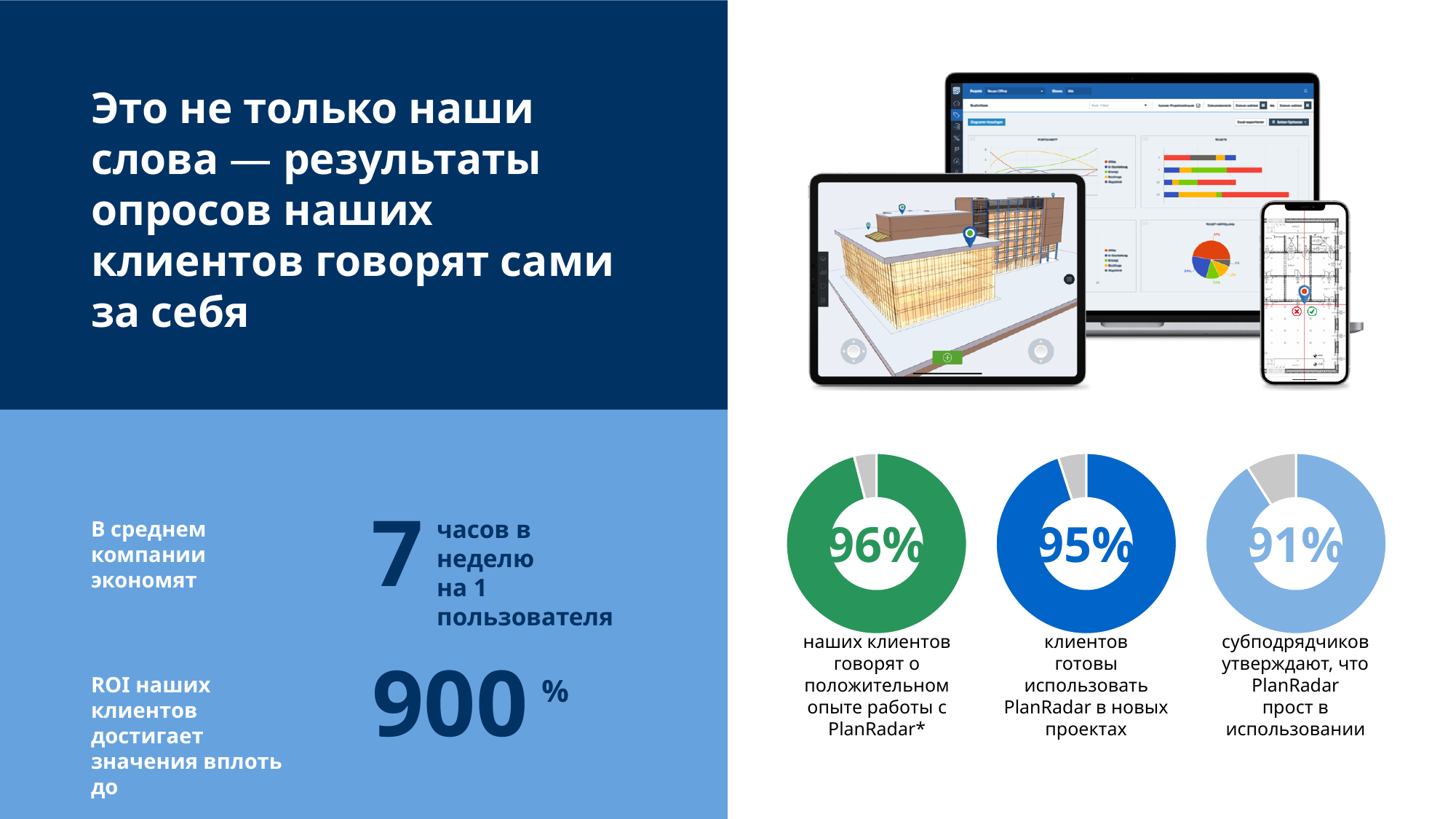
Among the three donut charts on the right side of the slide, which one shows the lowest percentage? The light-blue chart on the right (91%) What is the difference in percentage points between the green donut chart (96%) and the light-blue donut chart (91%)? 5 percentage points What colour is the filled portion of the donut chart showing 95%? Blue In the green donut chart on the left, what percentage of customers report a positive experience working with PlanRadar? 96% In the blue donut chart in the middle, what percentage of customers are ready to use PlanRadar in new projects? 95% Which is larger: the percentage in the green donut chart or the percentage in the light-blue donut chart? The green donut chart (96%) What kind of chart is used to show the 96%, 95% and 91% figures on the slide? Donut (pie) charts In the light-blue donut chart on the right, what percentage of subcontractors say PlanRadar is easy to use? 91% How many donut charts are shown on the slide? 3 Among the three donut charts on the right side of the slide, which one shows the highest percentage? The green chart on the left (96%) Is the value shown in the light-blue donut chart on the right greater or less than 90%? greater What is the difference in percentage points between the blue donut chart (95%) and the light-blue donut chart (91%)? 4 percentage points